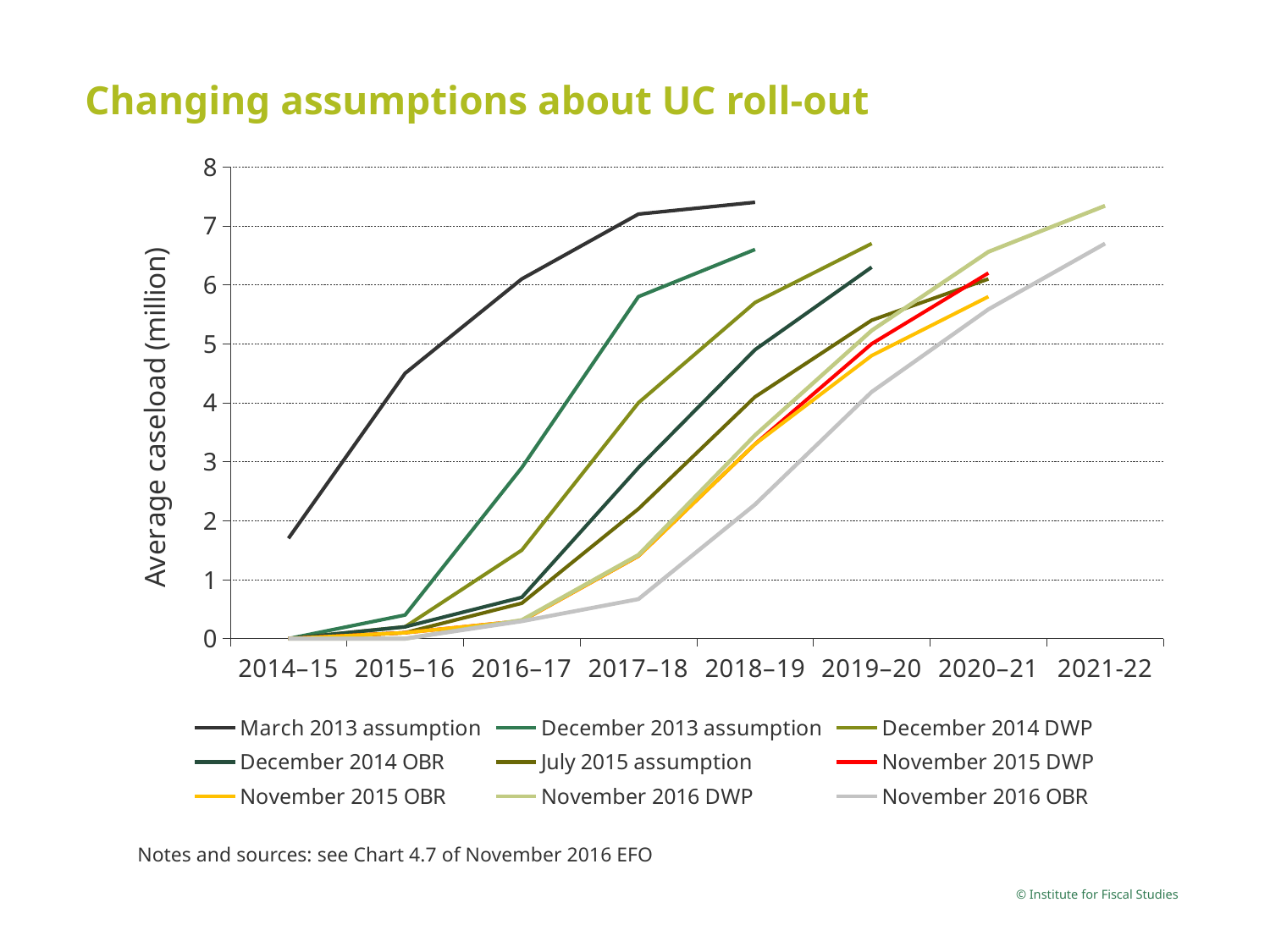
Is the value for the March 2013 assumption in 2016–17 greater or less than 5? greater In 2021-22, which is higher: November 2016 DWP or November 2016 OBR? November 2016 DWP Is the value for the December 2013 assumption in 2017–18 greater or less than 5? greater What kind of chart is shown on the slide? line chart Is the value for November 2016 OBR in 2019–20 greater or less than 5? less How many series does the legend list? 9 How many financial years are shown along the x axis? 8 Which series has the highest value in 2014–15? March 2013 assumption Does the March 2013 assumption line rise or fall from 2014–15 to 2018–19? rise What is the label on the y axis? Average caseload (million) In 2018–19, which is higher: the March 2013 assumption or December 2014 OBR? March 2013 assumption